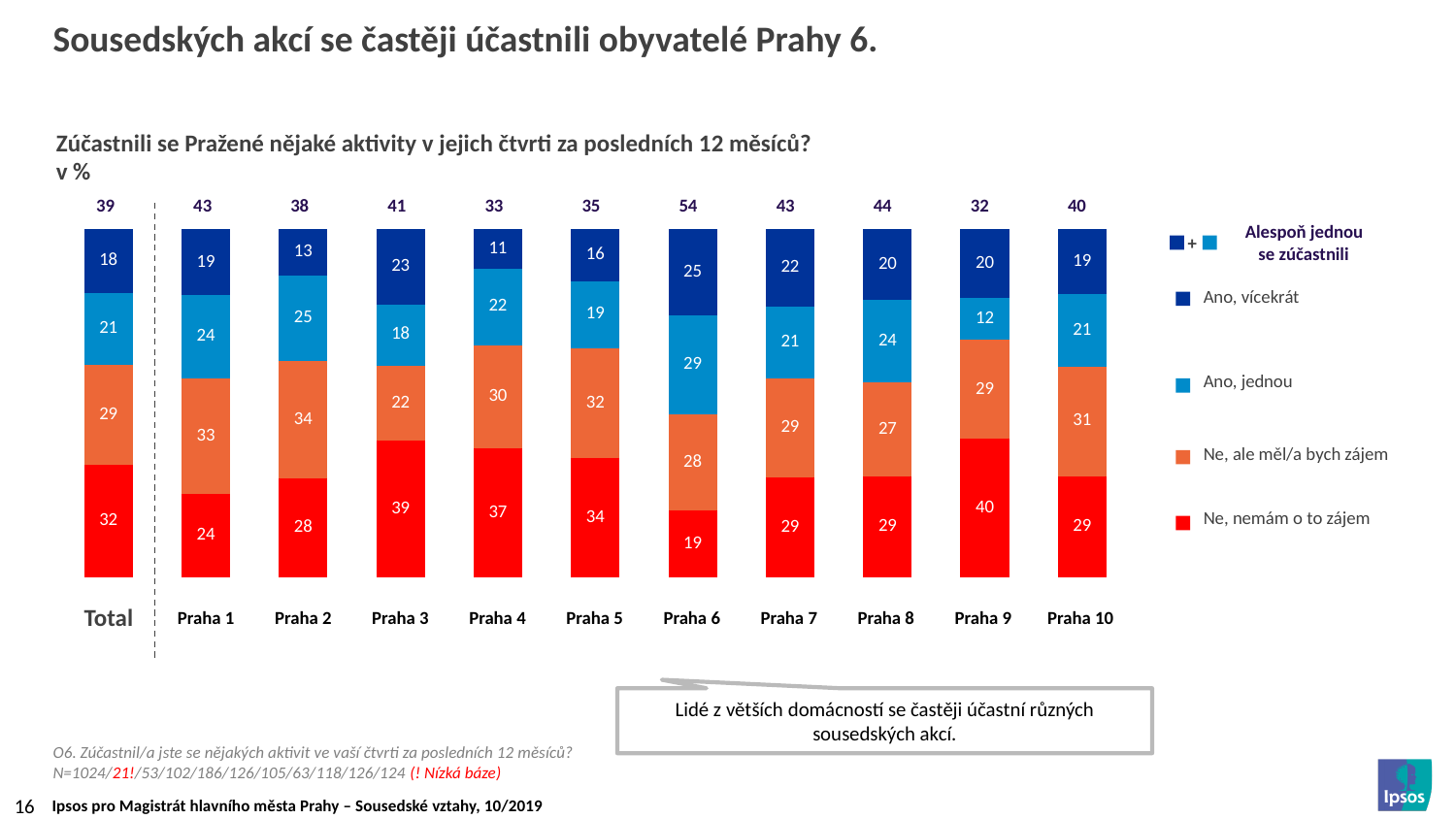
How many categories (bars) are plotted on the chart, including Total? 11 What is the difference between the 'Ne, nemám o to zájem' values for Praha 3 and Praha 6? 20 What kind of chart is shown on the slide? Stacked bar chart How many series does the legend list for the stacked bars? 4 What is the 'Alespoň jednou se zúčastnili' figure shown above the Praha 4 bar? 33 What is the total of the four stacked segments for the Total bar? 100 Which district has the highest 'Alespoň jednou se zúčastnili' figure? Praha 6 What is the value for 'Ne, nemám o to zájem' for Praha 9? 40 Which is larger: the 'Ne, ale měl/a bych zájem' value for Praha 2 or for Praha 3? Praha 2 What is the value for 'Ano, vícekrát' for Praha 6? 25 Which district has the lowest 'Ano, vícekrát' value? Praha 4 What is the value for 'Ano, jednou' for Praha 2? 25